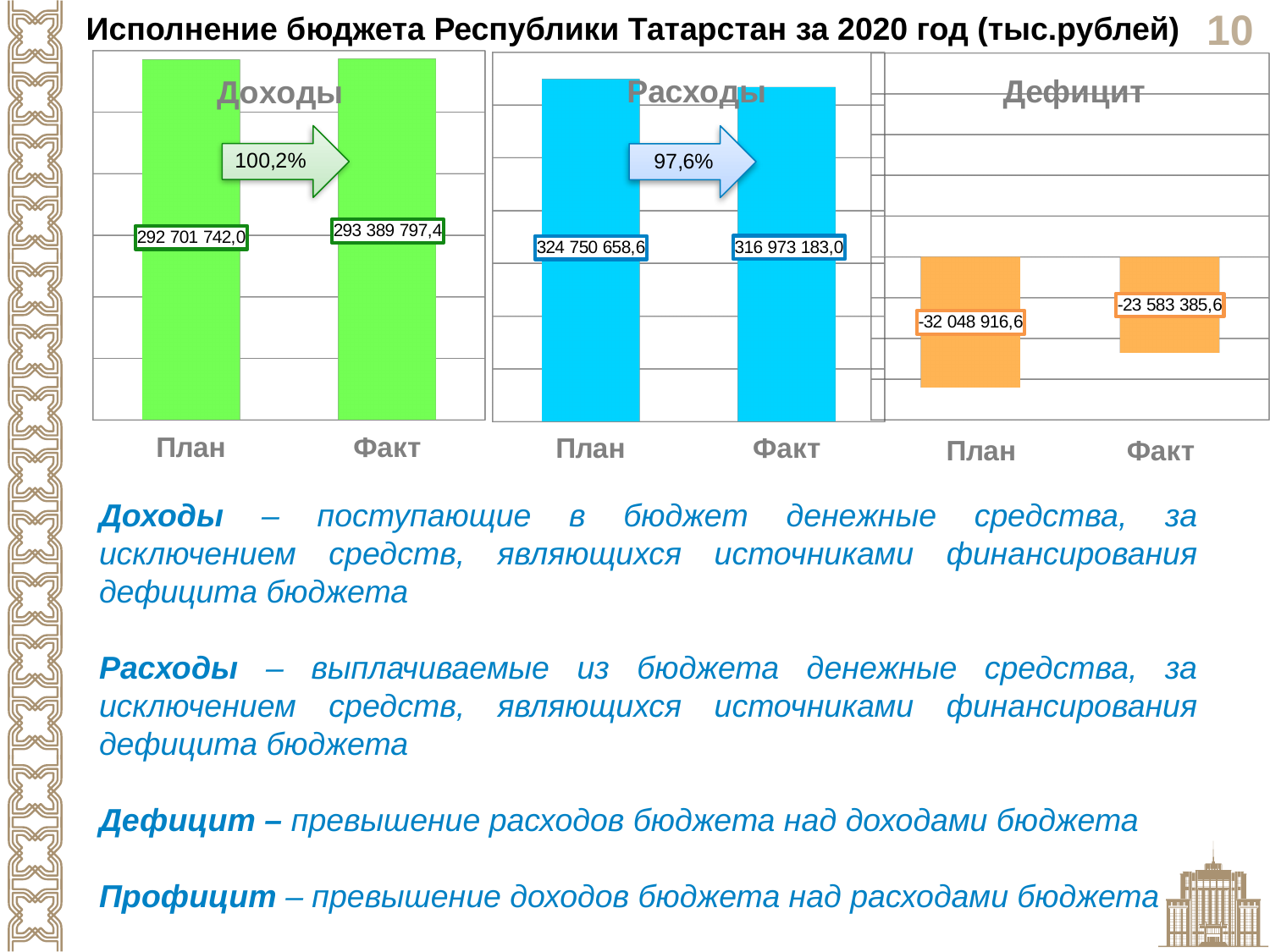
In the Доходы chart, which category has the higher value, План or Факт? Факт In the Доходы chart, what is the value for Факт? 293 389 797,4 In the Доходы chart, what is the value for План? 292 701 742,0 In the Расходы chart, what is the difference between the План and Факт values? 7 777 475,6 What percentage is shown on the arrow in the Расходы chart? 97,6% In the Расходы chart, which category has the higher value, План or Факт? План In the Расходы chart, what is the value for План? 324 750 658,6 In the Расходы chart, what is the value for Факт? 316 973 183,0 In the Дефицит chart, what is the value for Факт? -23 583 385,6 What type of chart is the Дефицит chart? Bar chart In the Дефицит chart, what is the value for План? -32 048 916,6 In the Доходы chart, what is the difference between the Факт and План values? 688 055,4